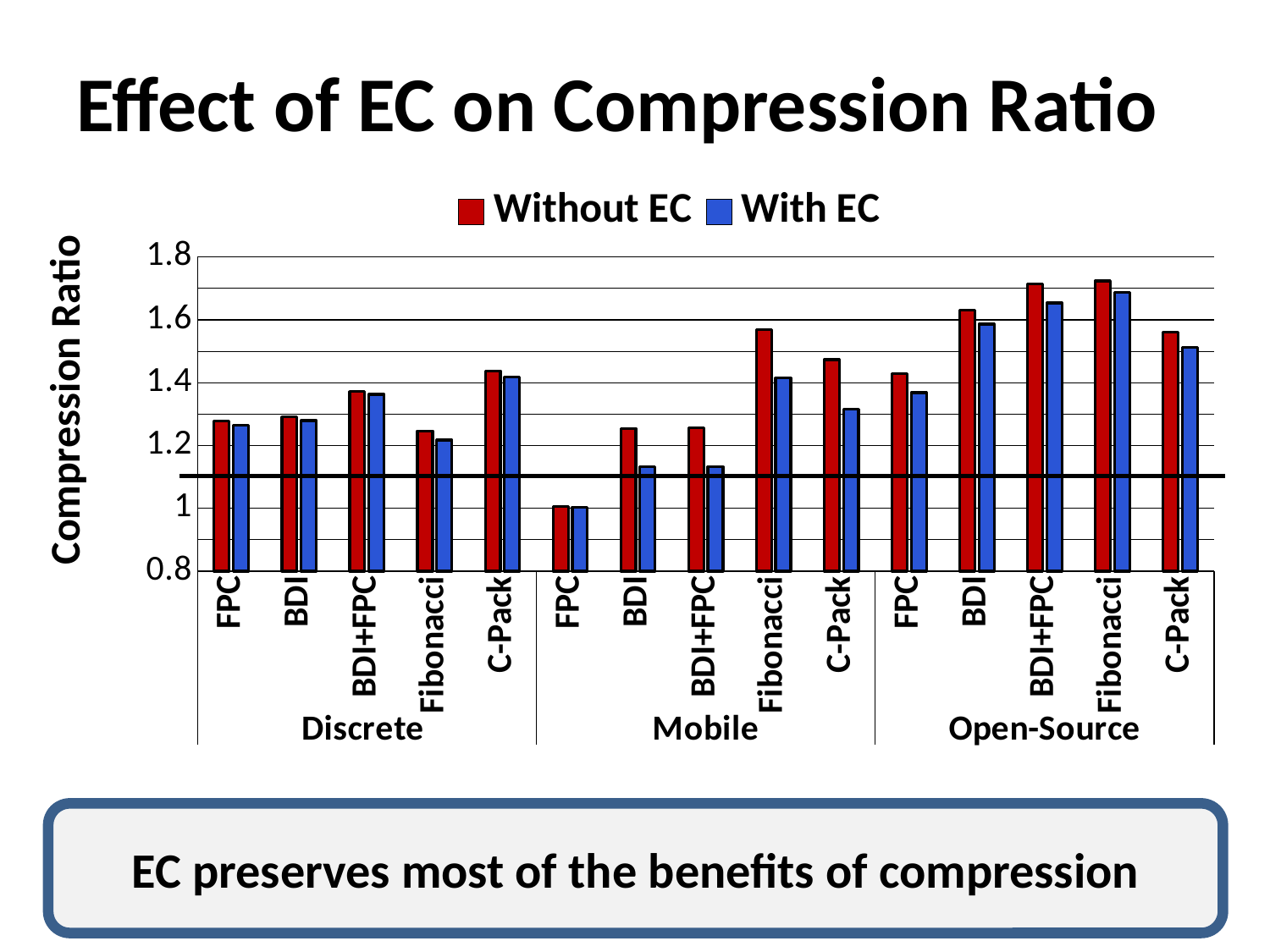
Is the Without EC value for Fibonacci in the Mobile group greater or less than 1.4? greater Which series is shown in red in the legend? Without EC For Fibonacci in the Mobile group, which is larger: the Without EC value or the With EC value? Without EC Is the With EC value for C-Pack in the Mobile group greater or less than 1.4? less Which category has the lowest compression ratio for the Without EC series? FPC (Mobile) What kind of chart is shown on the slide? bar chart For the Without EC series, which is larger: BDI+FPC in the Discrete group or BDI+FPC in the Open-Source group? BDI+FPC in the Open-Source group Is the With EC value for BDI in the Mobile group greater or less than 1.2? less How many series does the legend list? 2 What is the label of the y axis? Compression Ratio How many compression-scheme categories are plotted along the x axis in total across all three groups? 15